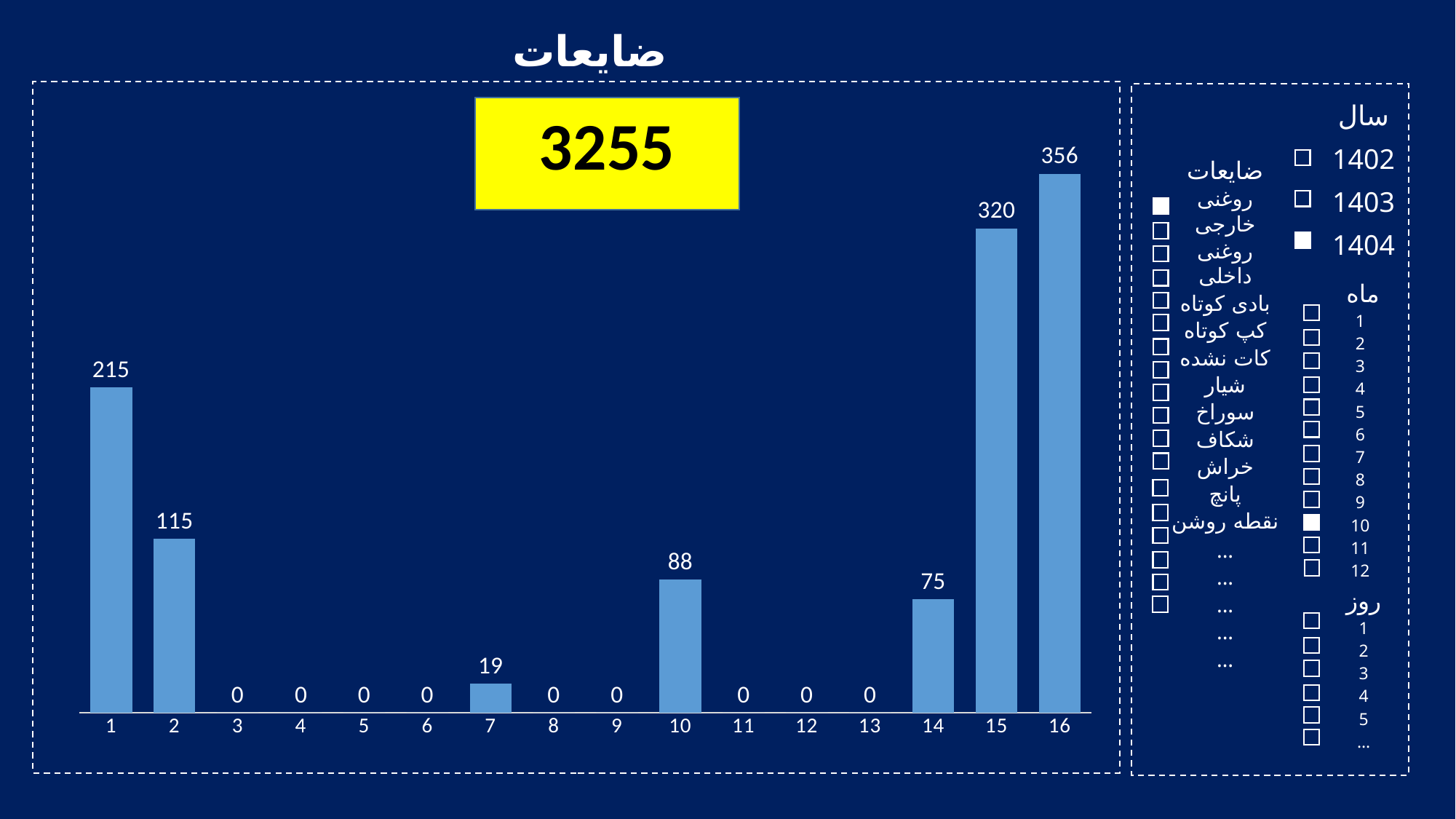
What number is shown in the yellow box above the chart? 3255 What is the value for category 7? 19 What is the difference between the values for categories 1 and 2? 100 What kind of chart is shown? bar chart What is the value for category 10? 88 Which is larger, the value for category 10 or the value for category 14? category 10 What is the value for category 1? 215 Which category has the highest value? 16 How many categories are shown on the x axis? 16 What is the difference between the values for categories 16 and 15? 36 How many categories have a value of 0? 9 What is the value for category 16? 356